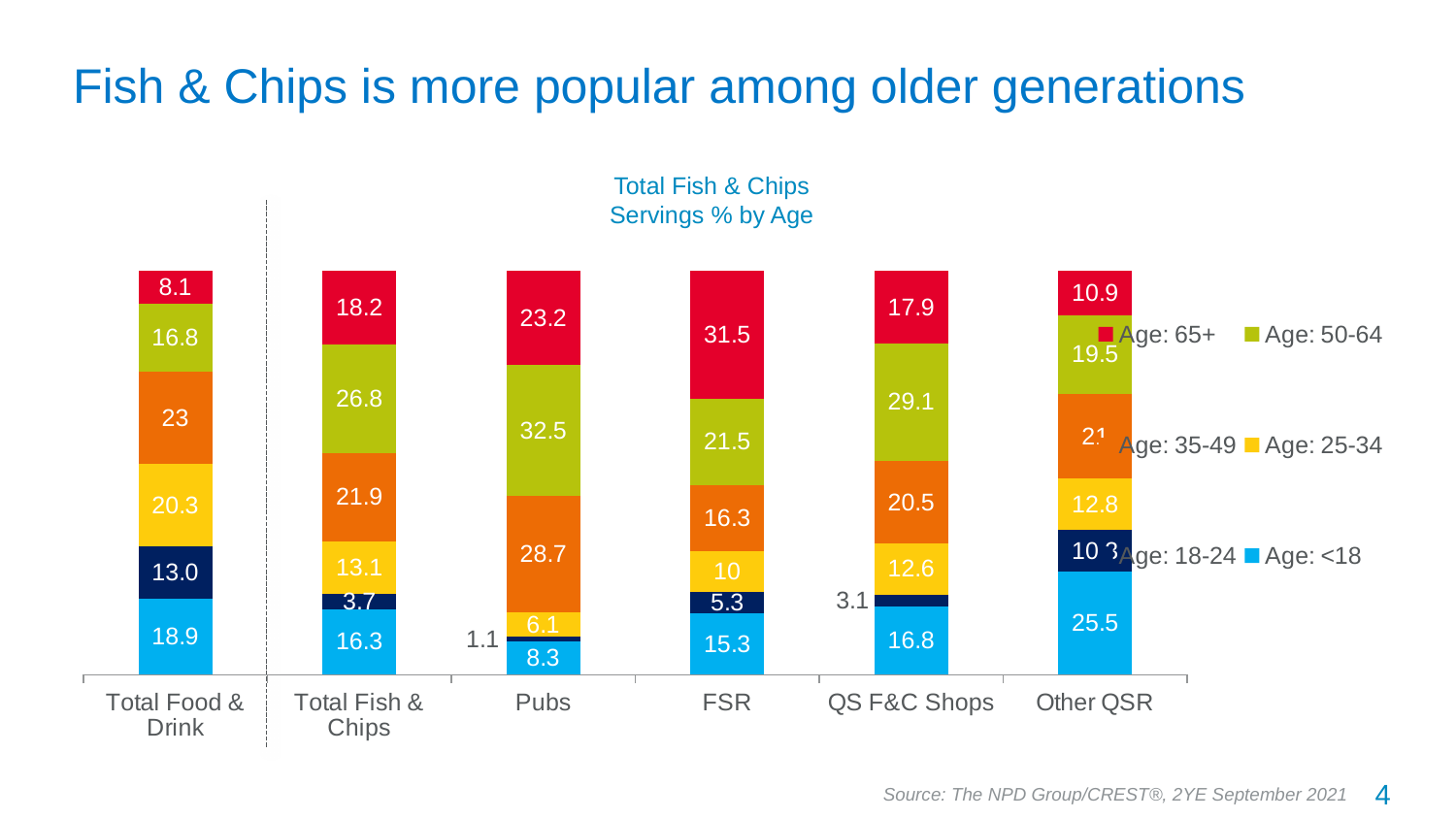
What is the difference between the Age: 50-64 values for Pubs and Total Fish & Chips? 5.7 How many categories are shown on the x axis? 6 Which has the larger Age: 35-49 value, Pubs or FSR? Pubs What is the Age: 65+ value for FSR? 31.5 Which category has the highest Age: 65+ value? FSR Which category has the highest Age: <18 value? Other QSR What is the Age: 18-24 value for Pubs? 1.1 How many series does the legend list? 6 Which category has the lowest Age: 18-24 value? Pubs What kind of chart is shown on the slide? Stacked bar chart What is the Age: <18 value for Other QSR? 25.5 What is the Age: 25-34 value for QS F&C Shops? 12.6